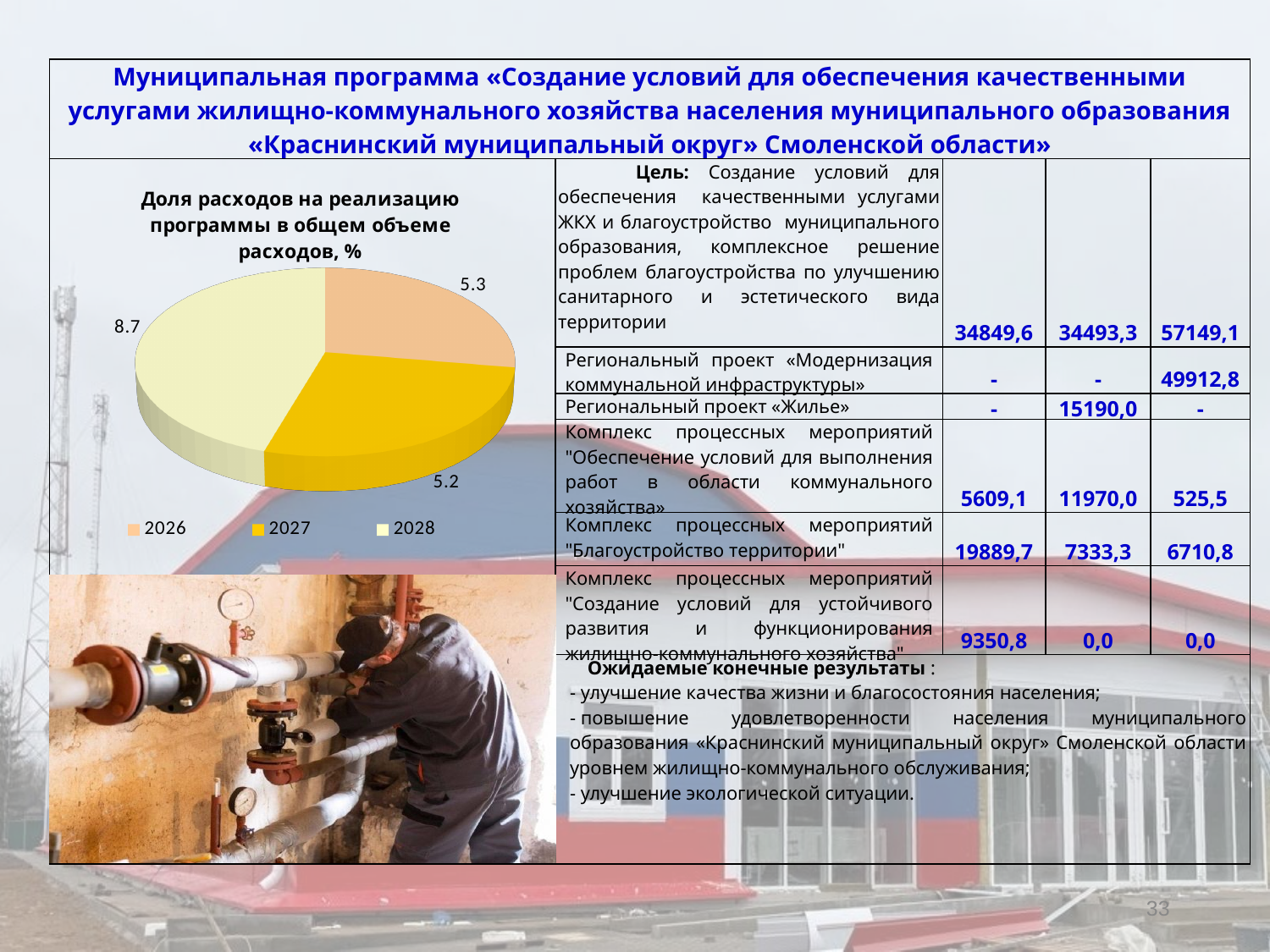
How many entries does the legend of the pie chart list? 3 Which year has the smallest slice in the pie chart? 2027 Which year is shown in yellow in the pie chart legend? 2027 Which year has the largest slice in the pie chart? 2028 What type of chart is shown on the slide? pie chart What is the value for 2026 in the pie chart? 5.3 What is the title of the pie chart? Доля расходов на реализацию программы в общем объеме расходов, % What is the value for 2027 in the pie chart? 5.2 Which is larger in the pie chart, the value for 2028 or the value for 2027? 2028 What is the difference between the values for 2028 and 2026 in the pie chart? 3.4 How many slices does the pie chart have? 3 What is the value for 2028 in the pie chart? 8.7